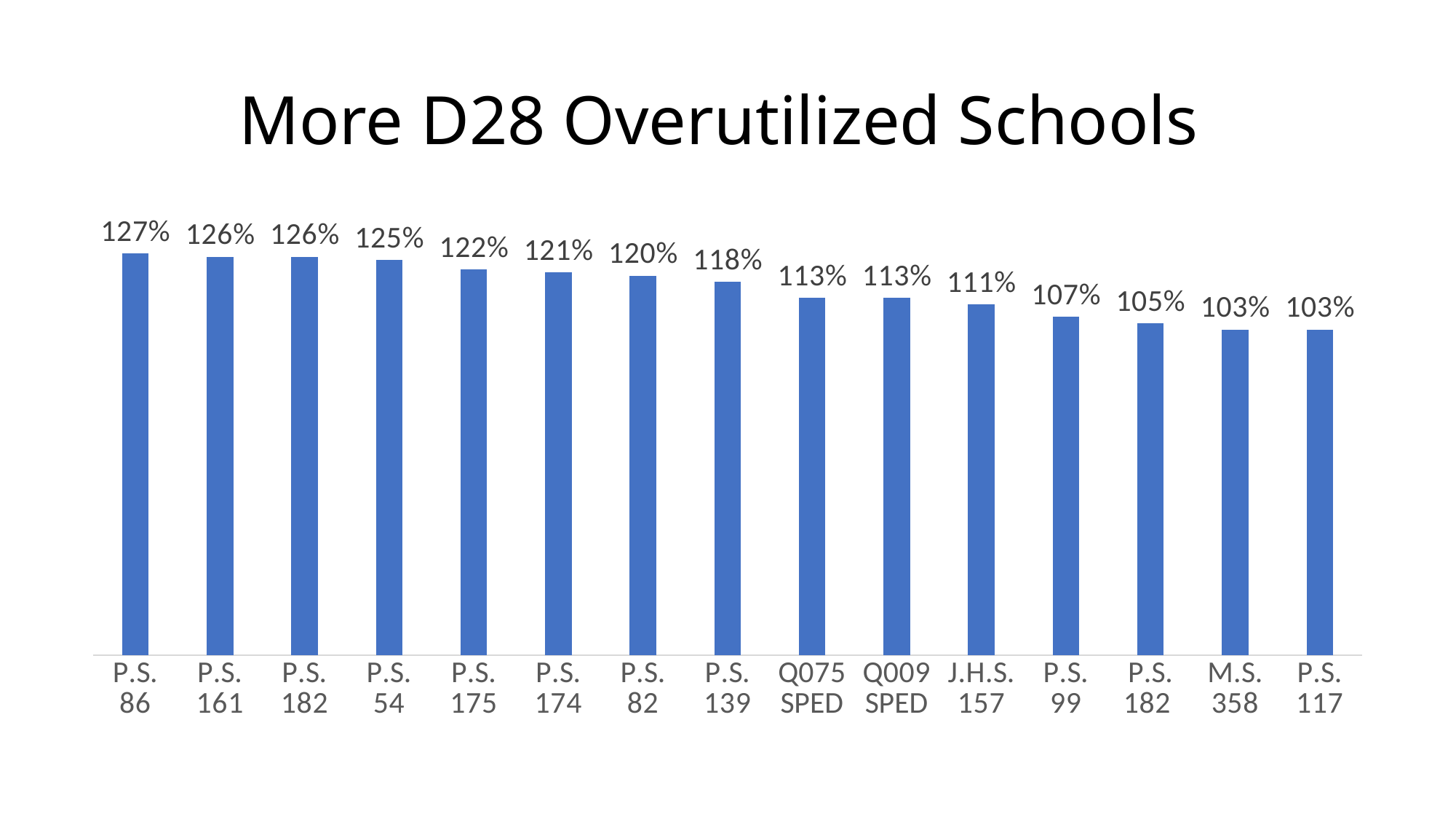
What kind of chart is shown on the slide? Bar chart What is the title of the chart? More D28 Overutilized Schools What is the difference between the values for P.S. 86 and P.S. 117? 24 percentage points Which school has the highest value? P.S. 86 What is the value for J.H.S. 157? 111% What is the value for P.S. 175? 122% What is the value for Q075 SPED? 113% Do the values rise or fall from left to right across the chart? Fall How many schools are shown in the chart? 15 Which has a larger value, P.S. 54 or P.S. 99? P.S. 54 What is the value for M.S. 358? 103% What is the value for P.S. 86? 127%